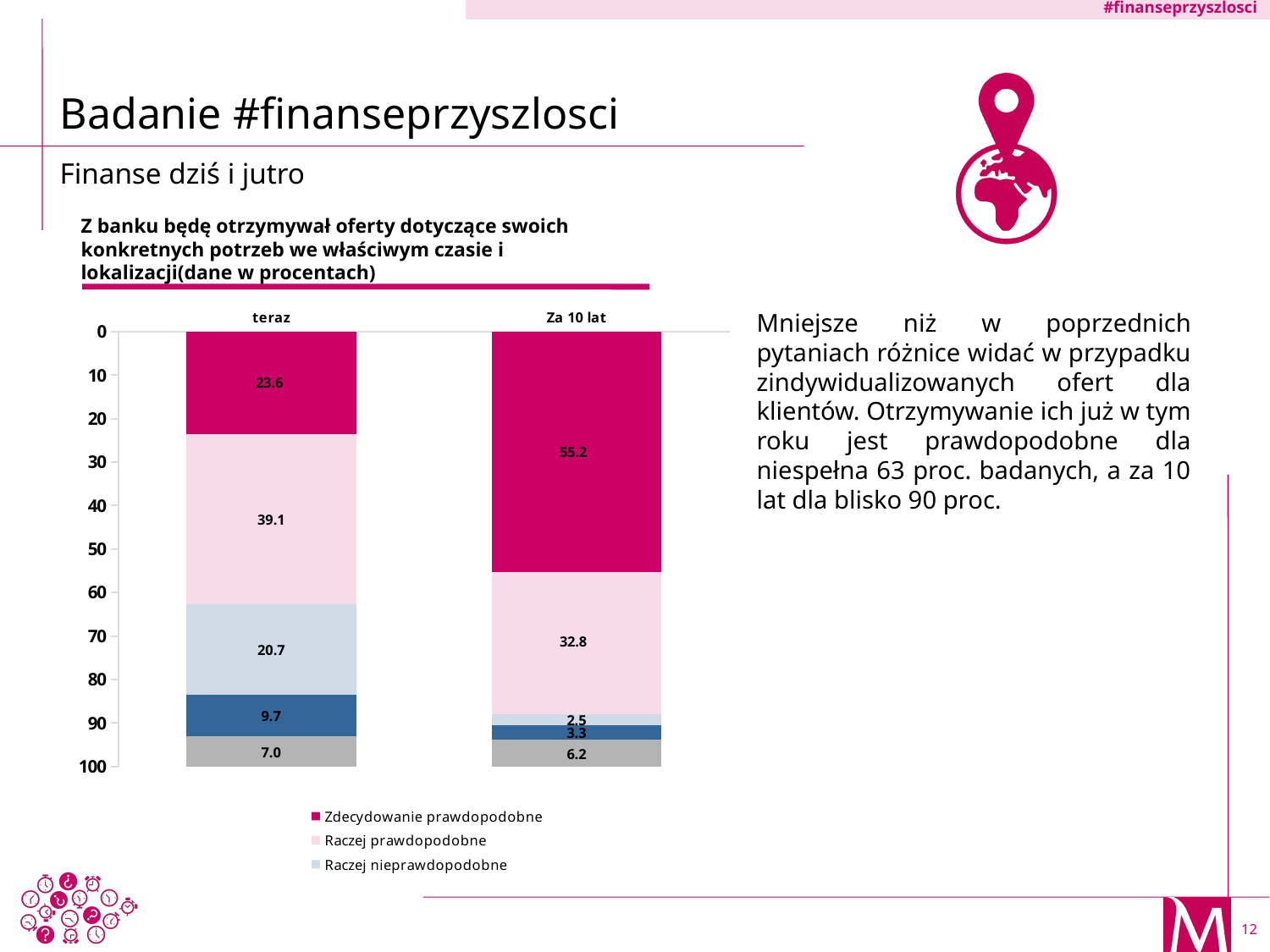
What is the value of the 'Raczej prawdopodobne' segment for 'teraz'? 39.1 Which has a larger 'Raczej prawdopodobne' value, 'teraz' or 'Za 10 lat'? teraz What is the value of the 'Zdecydowanie prawdopodobne' segment for 'Za 10 lat'? 55.2 What is the value of the 'Zdecydowanie prawdopodobne' segment for 'teraz'? 23.6 How many bars (categories) are shown in the chart? 2 What is the difference between the 'Zdecydowanie prawdopodobne' values for 'Za 10 lat' and 'teraz'? 31.6 Which segment is the largest in the 'teraz' bar? Raczej prawdopodobne What is the value of the 'Raczej nieprawdopodobne' segment for 'Za 10 lat'? 2.5 How many series does the legend list? 3 What is the difference between the 'Raczej nieprawdopodobne' values for 'teraz' and 'Za 10 lat'? 18.2 What type of chart is shown on the slide? Stacked bar chart Which segment is the largest in the 'Za 10 lat' bar? Zdecydowanie prawdopodobne